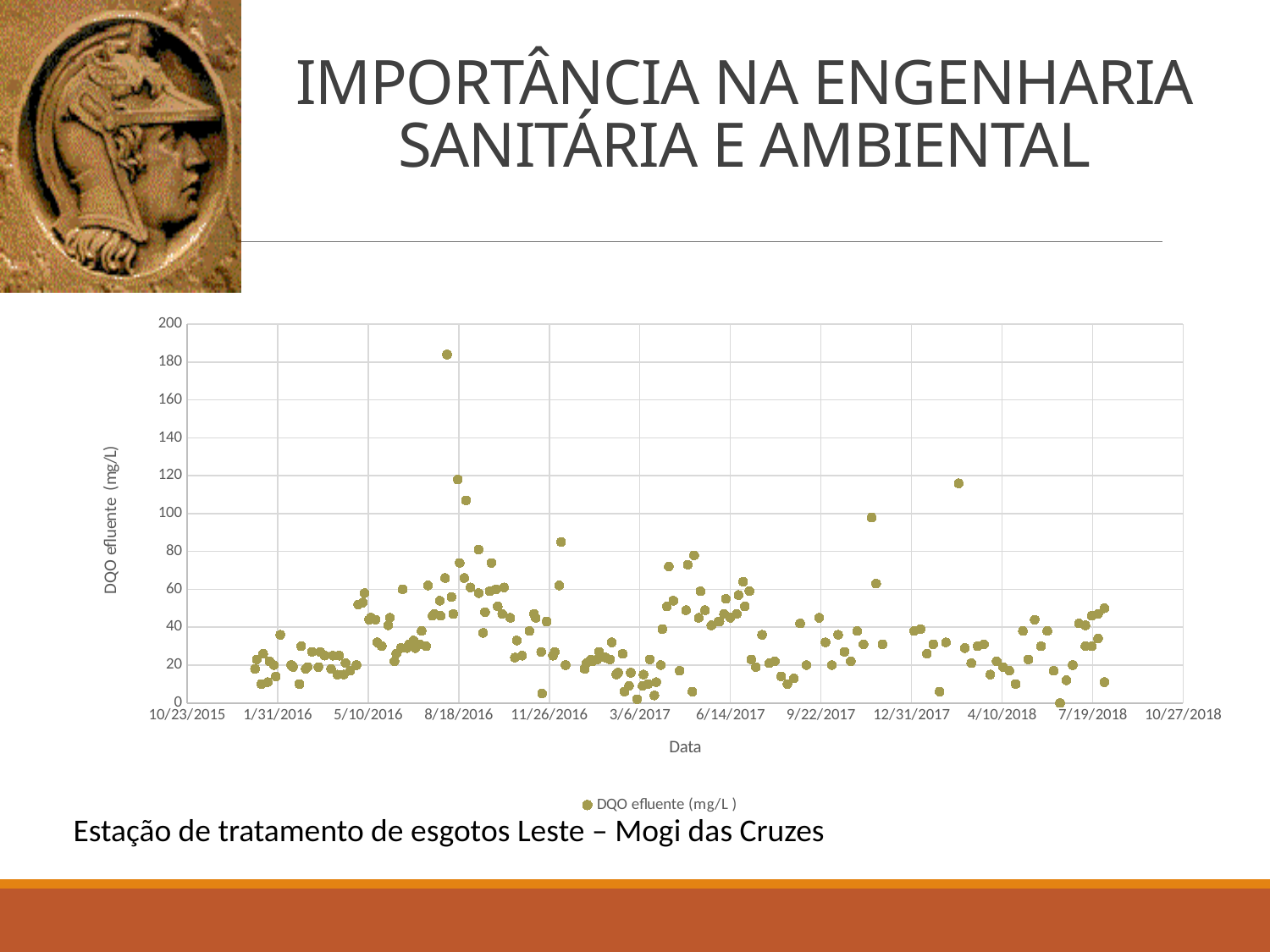
Is the lowest plotted value in the chart greater or less than 20? less How many series does the chart legend list? 1 Is the highest plotted value in the chart greater or less than 160? greater What is the last date tick shown on the horizontal axis of the chart? 10/27/2018 Is the highest plotted value in the chart greater or less than 200? less What is the maximum value shown on the vertical axis of the chart? 200 What is the first date tick shown on the horizontal axis of the chart? 10/23/2015 What kind of chart is shown on the slide? Scatter chart What is the title of the vertical axis of the chart? DQO efluente (mg/L) What is the interval between consecutive tick marks on the vertical axis of the chart? 20 What is the name of the series shown in the chart legend? DQO efluente (mg/L )